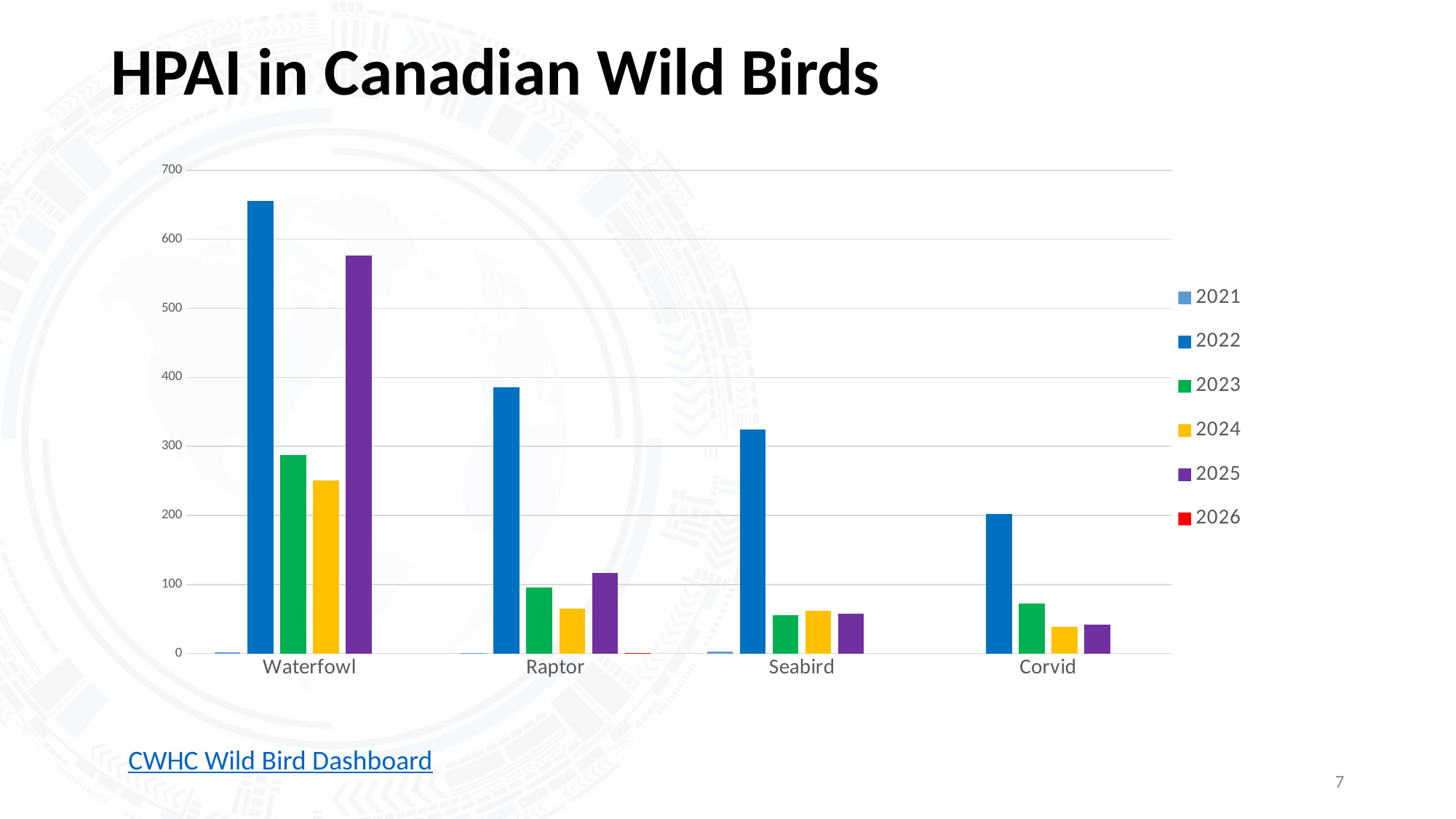
Is the value for Waterfowl in 2025 greater or less than 500? greater Which legend entry is shown in red? 2026 For Waterfowl, which year has the larger value, 2023 or 2024? 2023 Is the value for Waterfowl in 2022 greater or less than 600? greater Is the value for Seabird in 2022 greater or less than 300? greater What kind of chart is shown on the slide? bar chart Which bird category has the lowest value for 2022? Corvid What is the title of the slide containing the chart? HPAI in Canadian Wild Birds How many bird categories are shown on the x axis? 4 Which bird category has the highest value for 2022? Waterfowl How many series does the legend list? 6